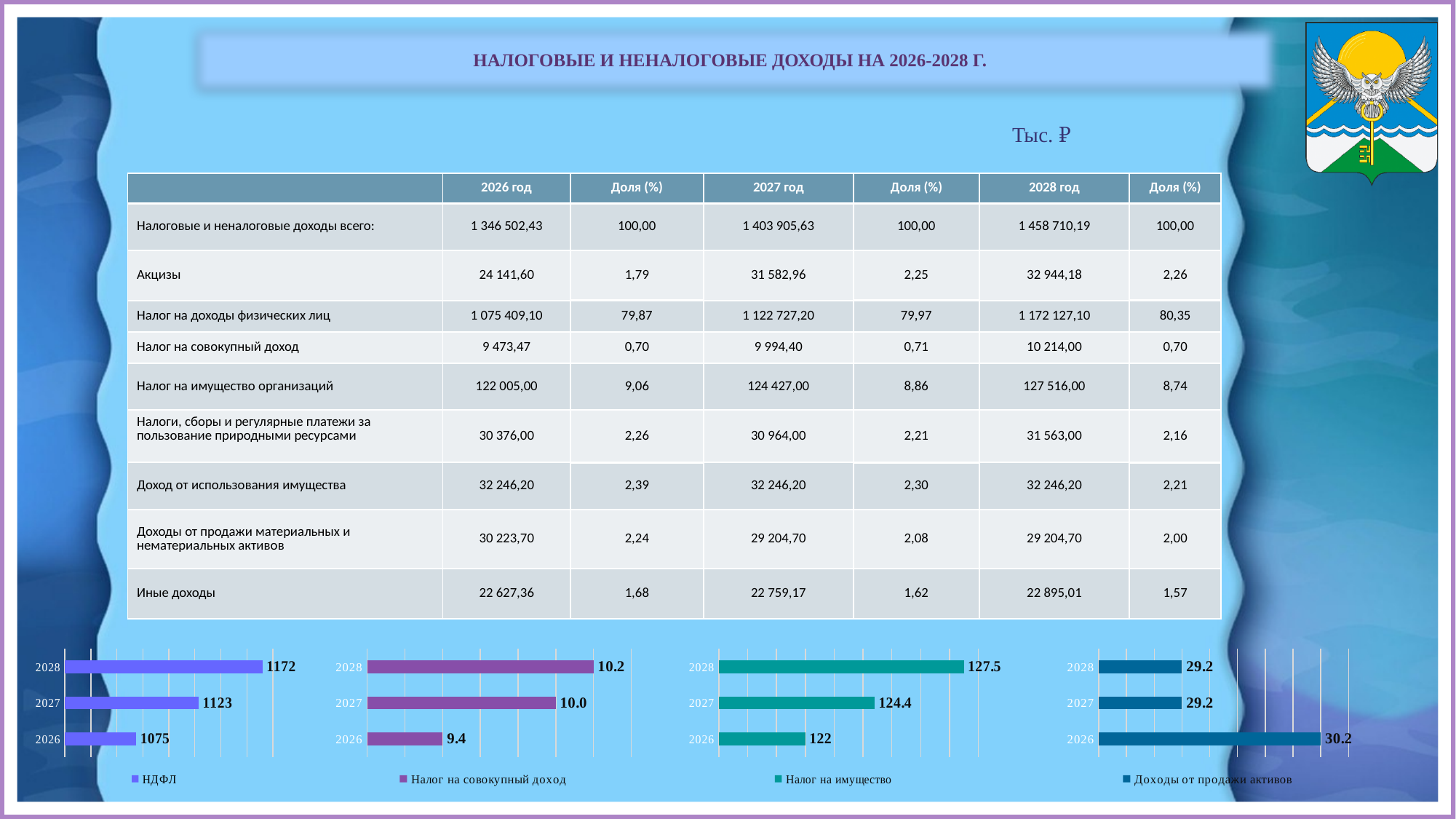
How many bar charts are shown at the bottom of the slide? 4 In the НДФЛ chart, which year has the highest value? 2028 In the НДФЛ chart, what is the value for 2028? 1172 In the Доходы от продажи активов chart, what is the value for 2026? 30.2 In the Доходы от продажи активов chart, which year has the highest value? 2026 In the НДФЛ chart, what is the difference between the 2028 and 2027 values? 49 In the Налог на совокупный доход chart, which is larger, the value for 2028 or for 2026? 2028 In the Налог на имущество chart, what is the value for 2028? 127.5 In the Налог на имущество chart, which year has the lowest value? 2026 In the Налог на совокупный доход chart, what is the value for 2027? 10.0 In the НДФЛ chart, what is the value for 2026? 1075 What kind of chart is the Налог на имущество chart? bar chart